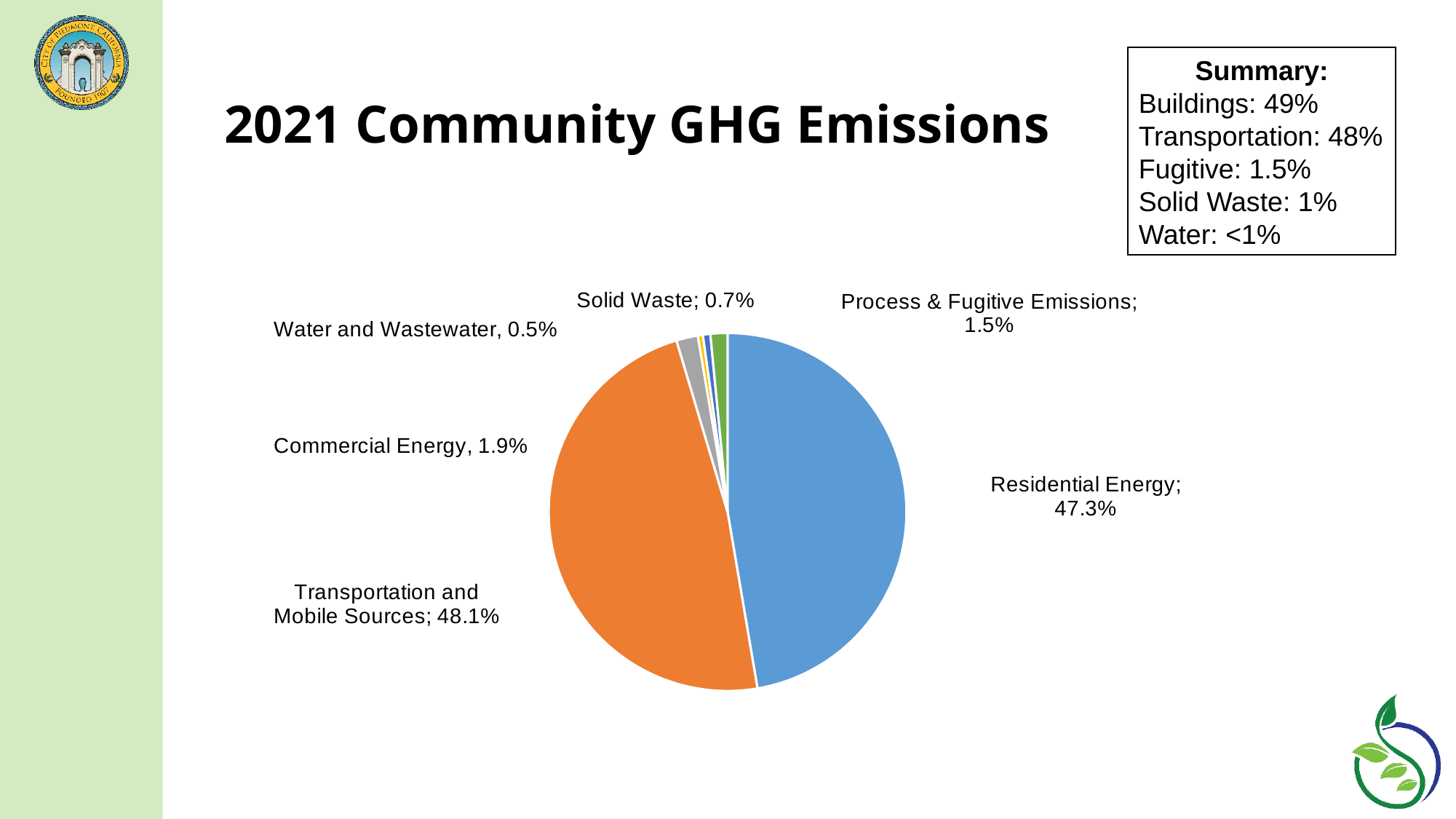
What type of chart is shown on the slide? pie chart What share of emissions comes from Solid Waste? 0.7% What share of emissions comes from Water and Wastewater? 0.5% What share of emissions is attributed to Transportation and Mobile Sources? 48.1% How many categories are shown in the pie chart? 6 What is the difference in percentage points between Transportation and Mobile Sources and Residential Energy? 0.8 Which category has the largest share of emissions? Transportation and Mobile Sources What percentage of emissions comes from Commercial Energy? 1.9% What is the share for Process & Fugitive Emissions? 1.5% Which category has the smallest share of emissions? Water and Wastewater What is the title of the chart? 2021 Community GHG Emissions What share of 2021 community GHG emissions comes from Residential Energy? 47.3%